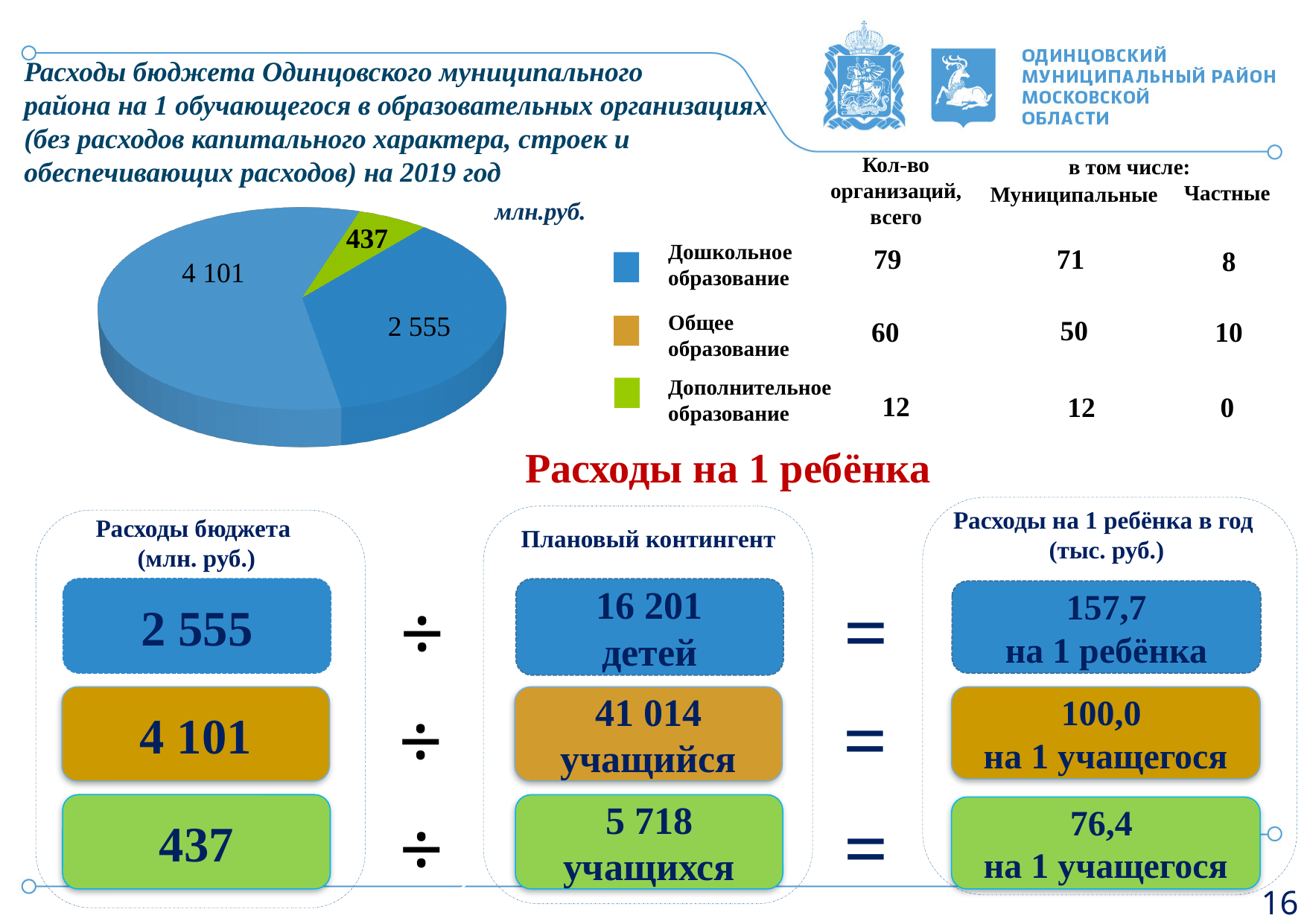
In what unit are the pie chart values given? млн.руб. What is the value of the largest slice of the pie chart? 4 101 What is the difference between the slice labelled 2 555 and the slice labelled 437? 2 118 What is the total of all three slices of the pie chart? 7 093 What is the value of the smallest slice of the pie chart? 437 What kind of chart is shown on the slide? pie chart Which legend entry is shown in green? Дополнительное образование How many entries does the legend of the pie chart list? 3 How many slices does the pie chart have? 3 What is the value of the green slice of the pie chart? 437 What is the difference between the two largest slices of the pie chart (4 101 and 2 555)? 1 546 Which slice is larger: the one labelled 2 555 or the one labelled 437? 2 555